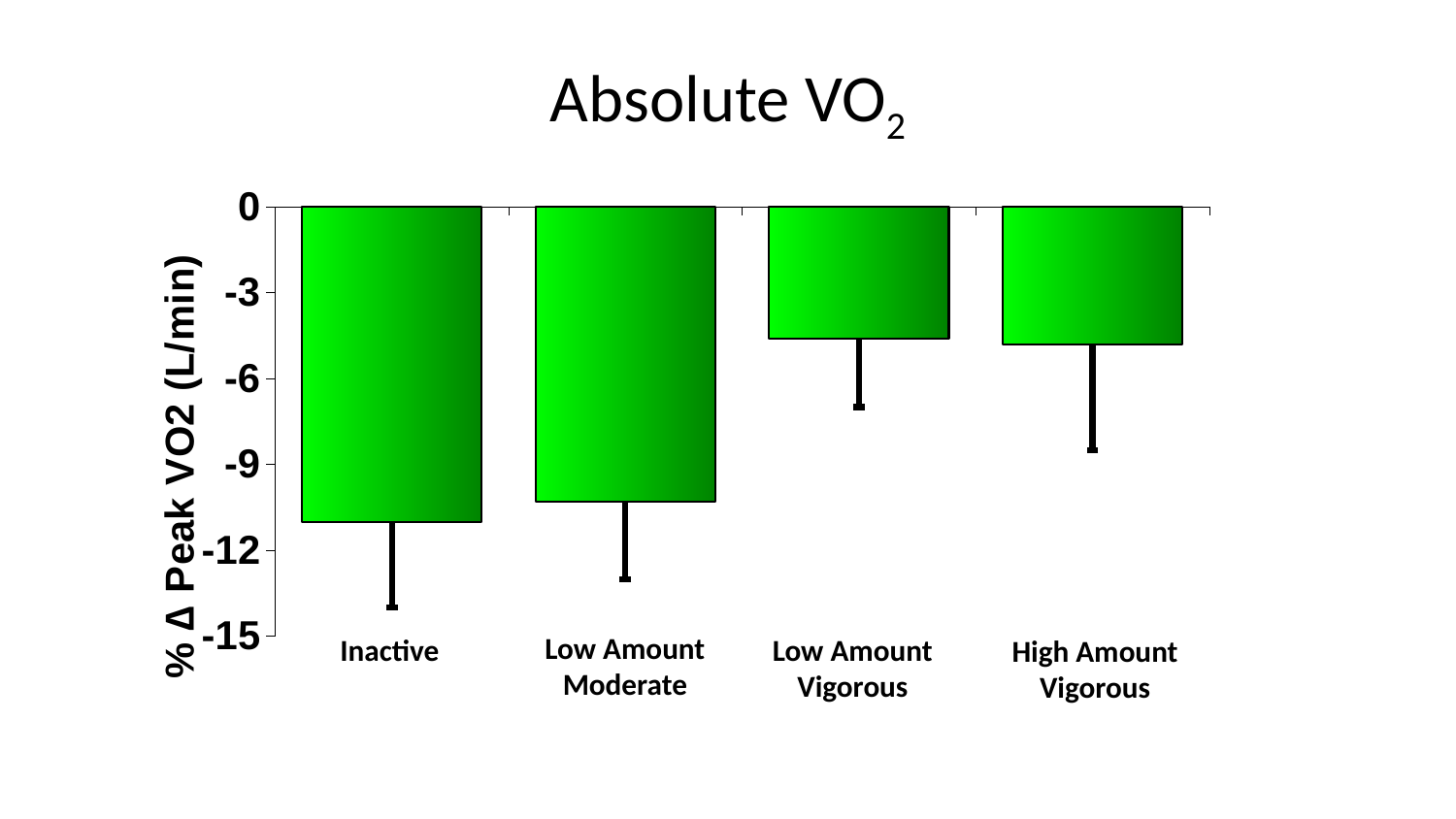
What is the title of the chart? Absolute VO2 Is the value for Low Amount Vigorous greater or less than -6? greater Which bar extends further below zero, Inactive or Low Amount Vigorous? Inactive Moving from left to right along the x axis, do the bar values generally rise or fall? rise Is the value for Low Amount Moderate greater or less than -9? less How many categories are plotted on the x axis? 4 Which category has the lowest (most negative) value? Inactive What kind of chart is shown on the slide? bar chart Is the value for Inactive greater or less than -9? less Which bar extends further below zero, Low Amount Moderate or High Amount Vigorous? Low Amount Moderate What is the label on the y axis? % Δ Peak VO2 (L/min)